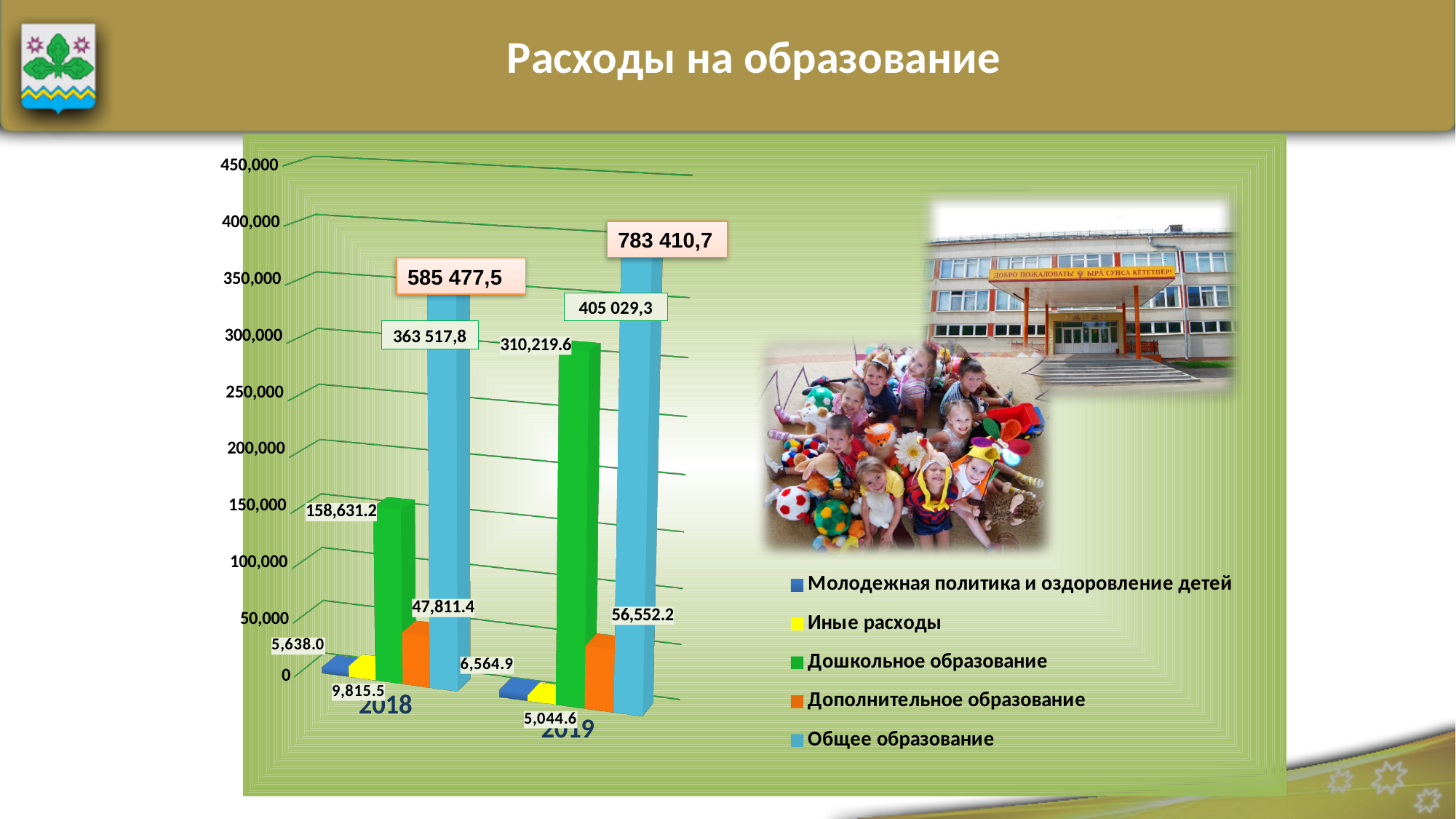
What is the value for Дошкольное образование in 2018? 158,631.2 Which series has the highest value in 2019? Общее образование What is the title of the chart on the slide? Расходы на образование How many series does the chart legend list? 5 How many years (categories) are shown on the x axis of the chart? 2 What kind of chart is shown on the slide? bar chart What is the value for Дошкольное образование in 2019? 310,219.6 By how much did Дошкольное образование increase from 2018 to 2019? 151,588.4 Does the value for Общее образование rise or fall from 2018 to 2019? rise Is the value for Дополнительное образование larger in 2018 or in 2019? 2019 What is the value for Дополнительное образование in 2019? 56,552.2 What is the value for Общее образование in 2018? 363 517,8